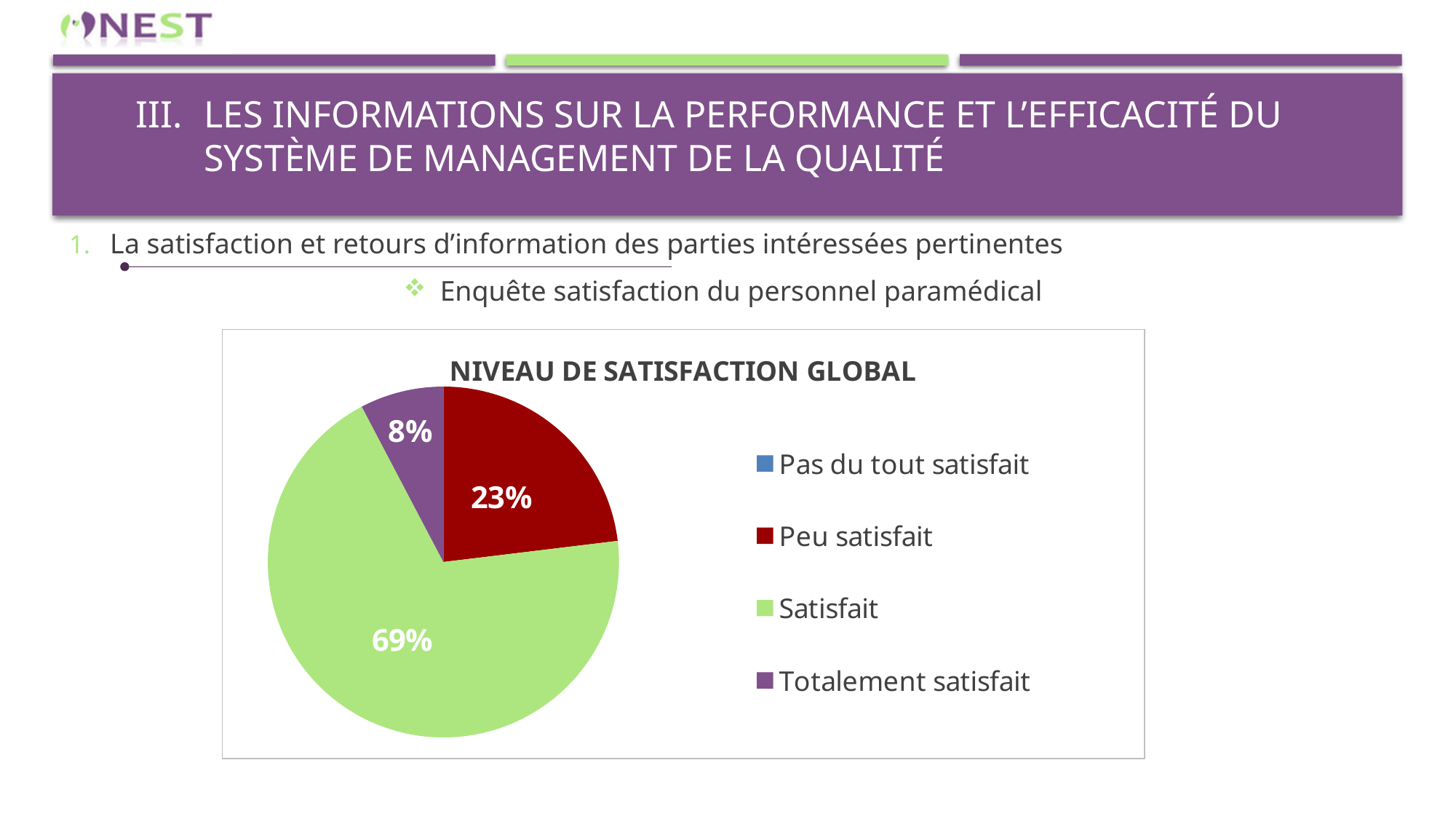
Which is larger, the share for "Peu satisfait" or the share for "Totalement satisfait"? Peu satisfait What percentage of respondents are "Satisfait"? 69% What is the difference in percentage points between "Peu satisfait" and "Totalement satisfait"? 15 What colour is the "Satisfait" slice? Green What is the title of the chart? NIVEAU DE SATISFACTION GLOBAL What percentage of respondents are "Peu satisfait"? 23% Which category has the largest slice of the pie? Satisfait Among the slices with a printed percentage, which category is the smallest? Totalement satisfait How many categories are listed in the chart's legend? 4 What type of chart is shown on the slide? Pie chart What is the difference in percentage points between "Satisfait" and "Peu satisfait"? 46 What percentage of respondents are "Totalement satisfait"? 8%